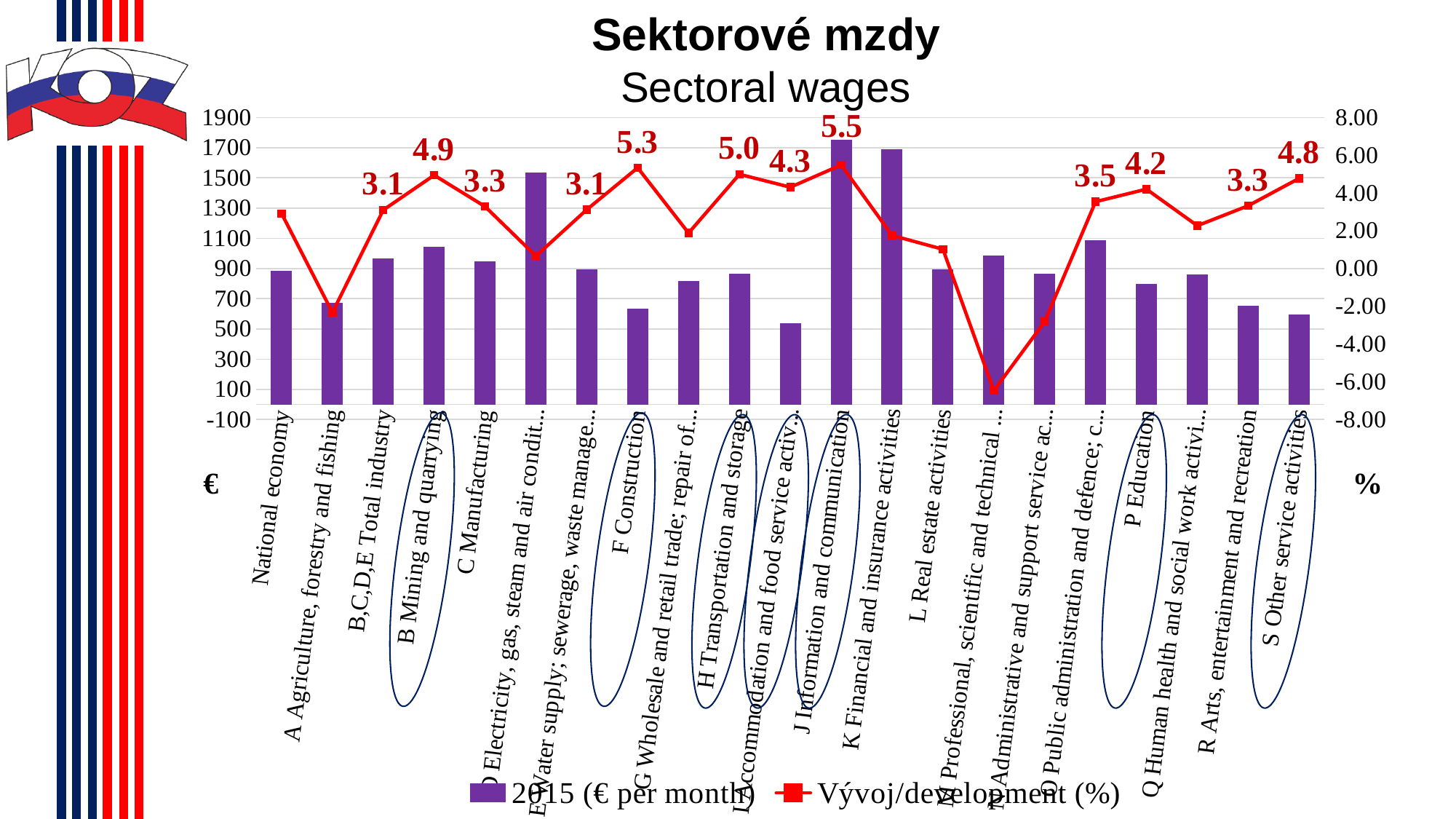
What is the development (%) value shown for F Construction? 5.3 How many series does the legend list? 2 Is the 2015 wage (€ per month) for I Accommodation and food service activities greater or less than 700? less What kind of chart is shown on the slide? Combination bar and line chart What is the development (%) value shown for J Information and communication? 5.5 Which category has the lowest point on the development (%) line? M Professional, scientific and technical Is the 2015 wage (€ per month) for K Financial and insurance activities greater or less than 1500? greater What is the difference between the development (%) values for J Information and communication and B,C,D,E Total industry? 2.4 What is the development (%) value shown for S Other service activities? 4.8 Which category has the highest labelled development (%) value? J Information and communication What is the development (%) value shown for P Education? 4.2 Which has a higher development (%) value, F Construction or B Mining and quarrying? F Construction